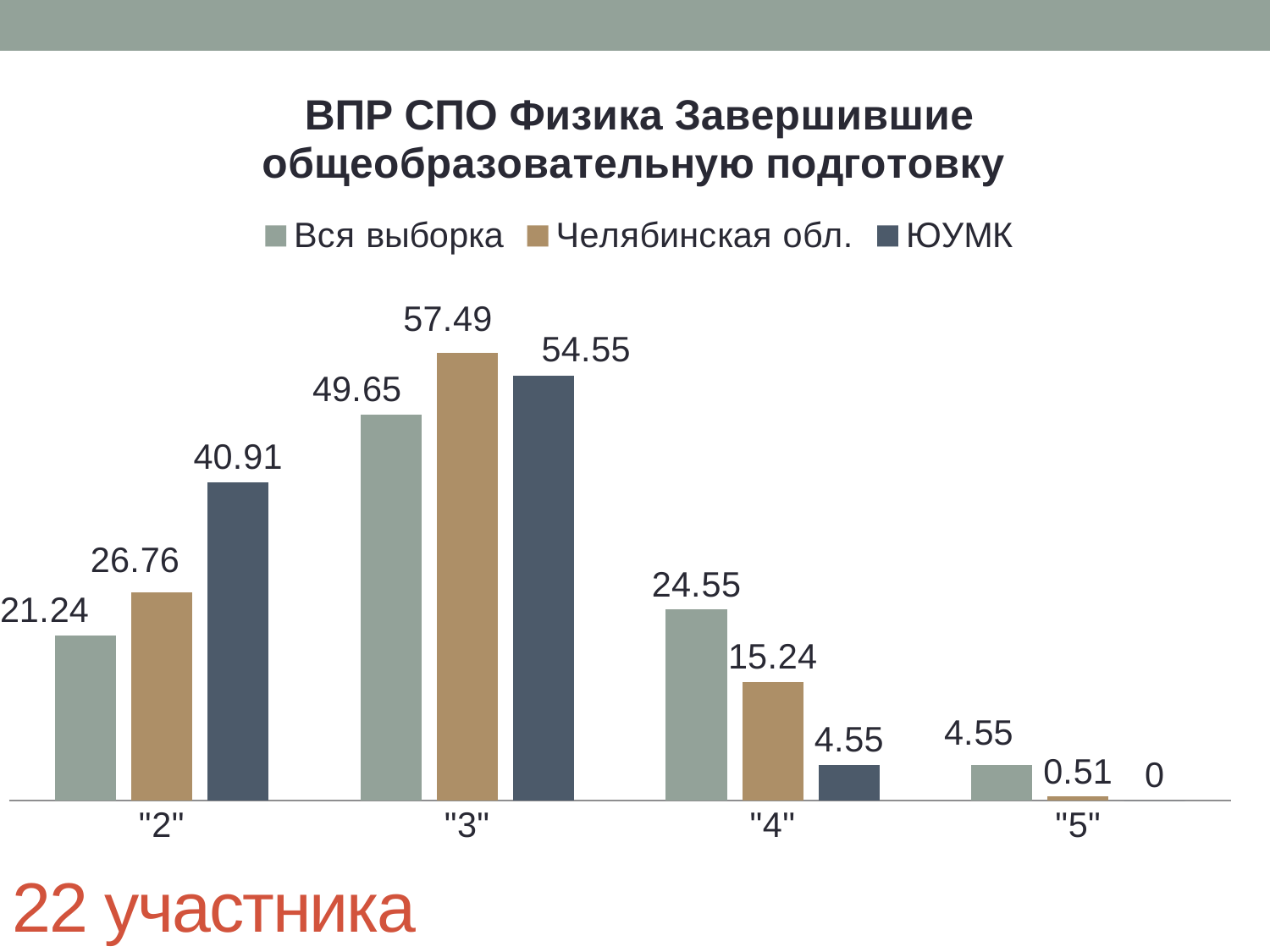
Which category has the highest value for the Вся выборка series? "3" What is the difference between the Челябинская обл. and Вся выборка values in category "3"? 7.84 What is the value for ЮУМК in category "5"? 0 What kind of chart is shown on the slide? Bar chart What is the value for Вся выборка in category "4"? 24.55 Which category has the lowest value for the Челябинская обл. series? "5" What is the title of the chart? ВПР СПО Физика Завершившие общеобразовательную подготовку How many series does the legend list? 3 In category "2", which series has the larger value: Вся выборка or ЮУМК? ЮУМК What is the value for Челябинская обл. in category "3"? 57.49 How many categories are shown on the x axis? 4 What is the value for ЮУМК in category "2"? 40.91